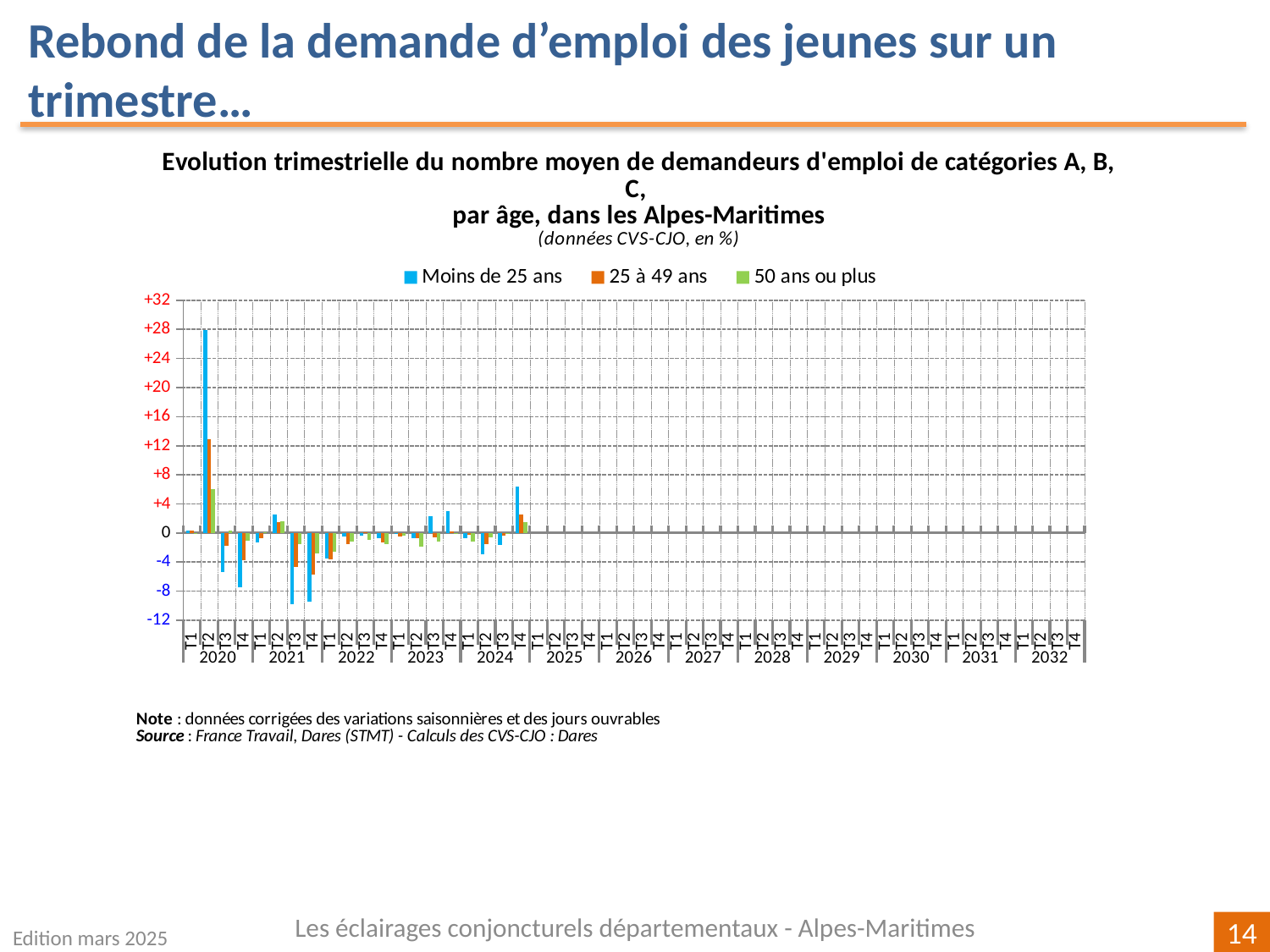
In 2020 T2, which is larger: the value for 'Moins de 25 ans' or for '25 à 49 ans'? Moins de 25 ans Which colour represents the 'Moins de 25 ans' series? blue Which series has the highest value in 2020 T2? Moins de 25 ans How many series does the legend list? 3 Is the value for '25 à 49 ans' in 2020 T2 greater or less than +8? greater What kind of chart is shown on the slide? bar chart Is the value for '50 ans ou plus' in 2020 T2 greater or less than +8? less Is the value for 'Moins de 25 ans' in 2021 T3 greater or less than -8? less Which series has the lowest value in 2021 T3? Moins de 25 ans What are the three series listed in the legend? Moins de 25 ans, 25 à 49 ans, 50 ans ou plus